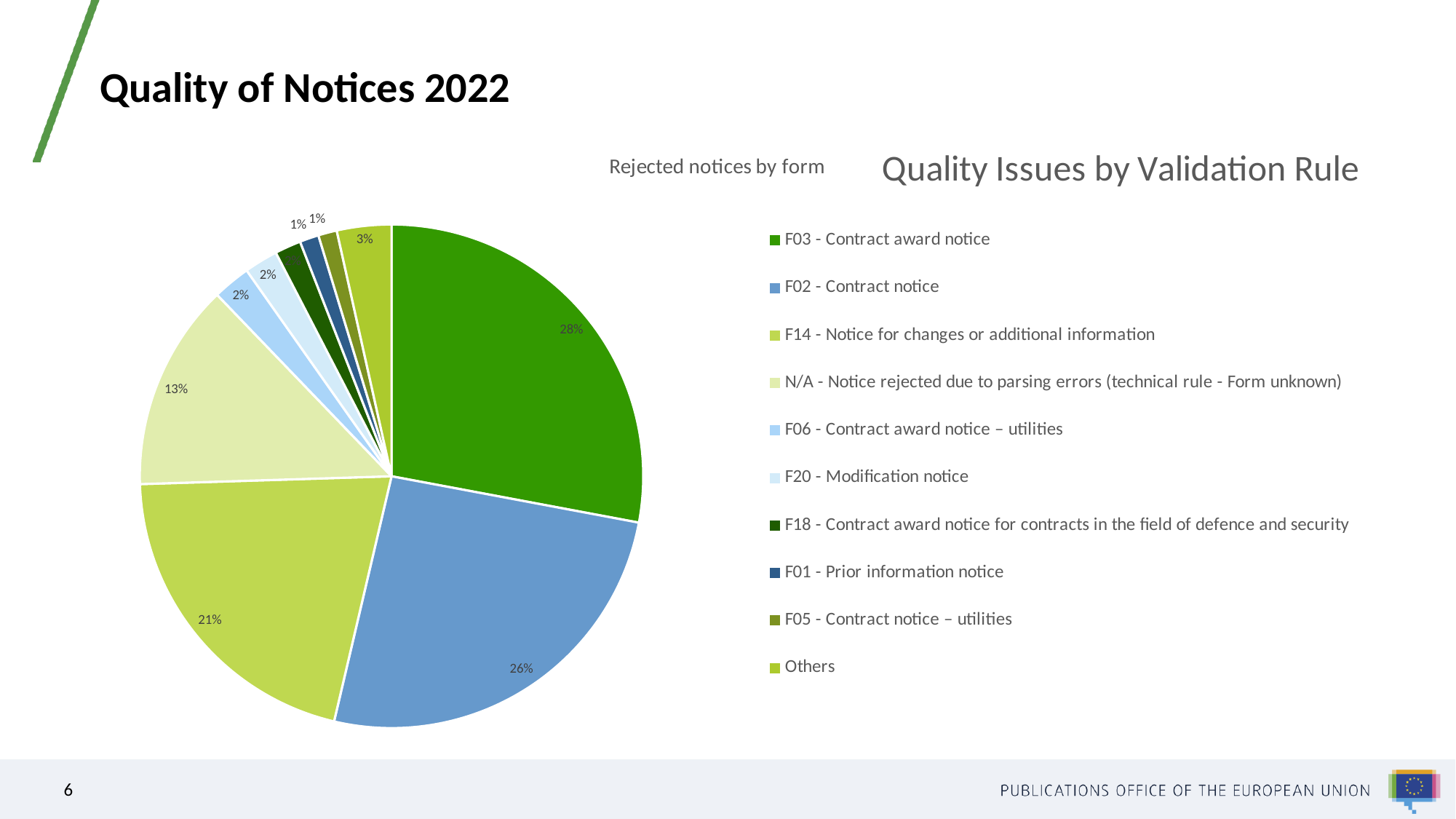
What is the title of the pie chart? Rejected notices by form How many entries does the legend of the pie chart list? 10 What kind of chart is shown on the slide? pie chart What share of the pie does N/A - Notice rejected due to parsing errors have? 13% What share of the pie does F02 - Contract notice have? 26% What is the difference in percentage points between the F03 - Contract award notice slice and the F02 - Contract notice slice? 2 What colour is the slice for F02 - Contract notice? blue What share of the pie does F14 - Notice for changes or additional information have? 21% Which form has the largest slice of the pie? F03 - Contract award notice Which slice is larger, F14 - Notice for changes or additional information or N/A - Notice rejected due to parsing errors? F14 - Notice for changes or additional information